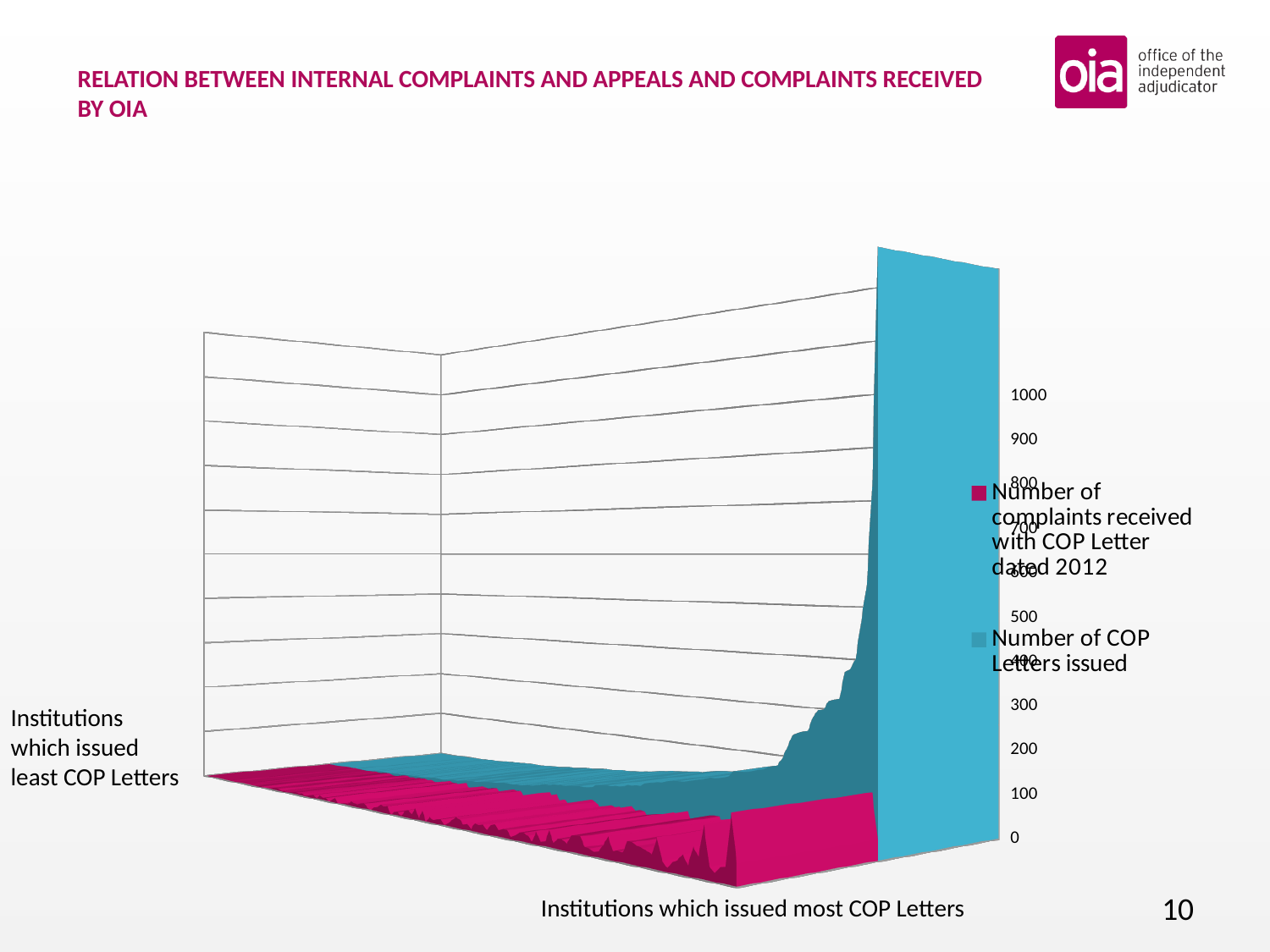
What kind of chart is shown on the slide? area chart Do the values for Number of COP Letters issued rise or fall moving from left to right along the x axis? rise What is the title of the chart? Relation between internal complaints and appeals and complaints received by OIA Is the highest value for Number of COP Letters issued greater or less than 500? greater What is the highest tick value shown on the vertical axis? 1000 Which series reaches higher values, Number of COP Letters issued or Number of complaints received with COP Letter dated 2012? Number of COP Letters issued How many series does the legend list? 2 Is the highest value for Number of complaints received with COP Letter dated 2012 greater or less than 500? less Which series is shown in blue? Number of COP Letters issued